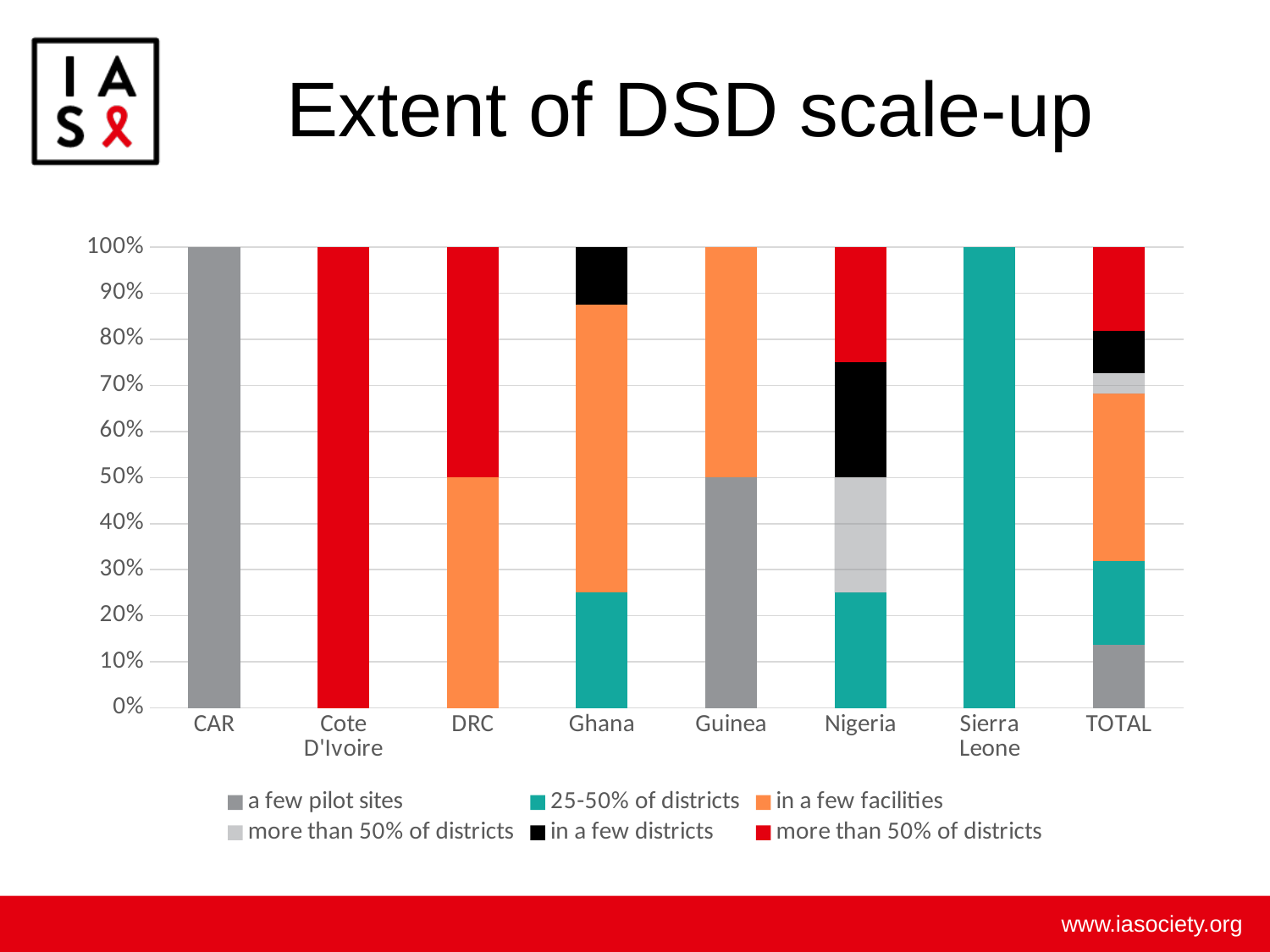
What share of the Sierra Leone bar is '25-50% of districts'? 100% What share of the CAR bar is 'a few pilot sites'? 100% In the TOTAL bar, which segment is larger: 'in a few facilities' or '25-50% of districts'? in a few facilities What is the title of the slide containing the chart? Extent of DSD scale-up What share of the Cote D'Ivoire bar is 'more than 50% of districts' (red)? 100% How many categories are shown along the x axis of the chart? 8 How many of the bars consist of a single series only? 3 In the Nigeria bar, is the share for 'more than 50% of districts' (red) greater or less than 30%? less What share of the Guinea bar is 'a few pilot sites'? 50% What kind of chart is shown on the slide? Stacked bar chart What share of the DRC bar is 'in a few facilities'? 50% How many series does the chart legend list? 6